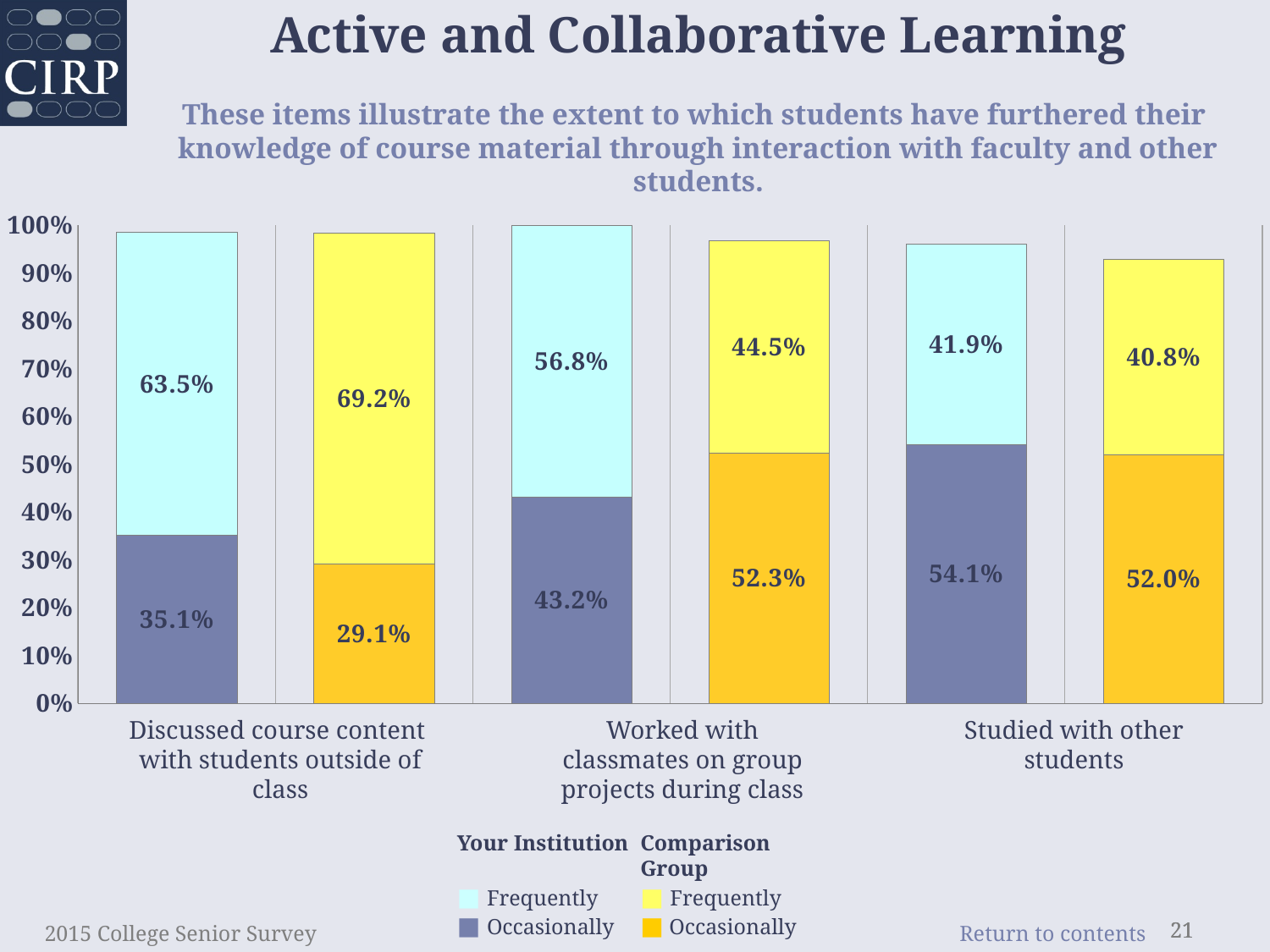
What is the total of the Comparison Group stacked bar for 'Studied with other students'? 92.8% What type of chart is shown on the slide? Stacked bar chart Which 'Occasionally' value is the lowest on the chart? 29.1% (Comparison Group, Discussed course content with students outside of class) What is the difference between the Your Institution and Comparison Group 'Frequently' values for 'Worked with classmates on group projects during class'? 12.3 percentage points What percentage of the Comparison Group reported 'Occasionally' for 'Worked with classmates on group projects during class'? 52.3% What is the total of the Your Institution stacked bar for 'Worked with classmates on group projects during class'? 100.0% What percentage of Your Institution students reported 'Frequently' for 'Discussed course content with students outside of class'? 63.5% Across all bars, which 'Frequently' value is the highest? 69.2% (Comparison Group, Discussed course content with students outside of class) For 'Studied with other students', which is larger: the Your Institution 'Occasionally' value or the Comparison Group 'Occasionally' value? Your Institution (54.1%) How many categories are shown along the x axis? 3 What is the 'Frequently' value for the Comparison Group for 'Studied with other students'? 40.8% How many entries does the legend list? 4